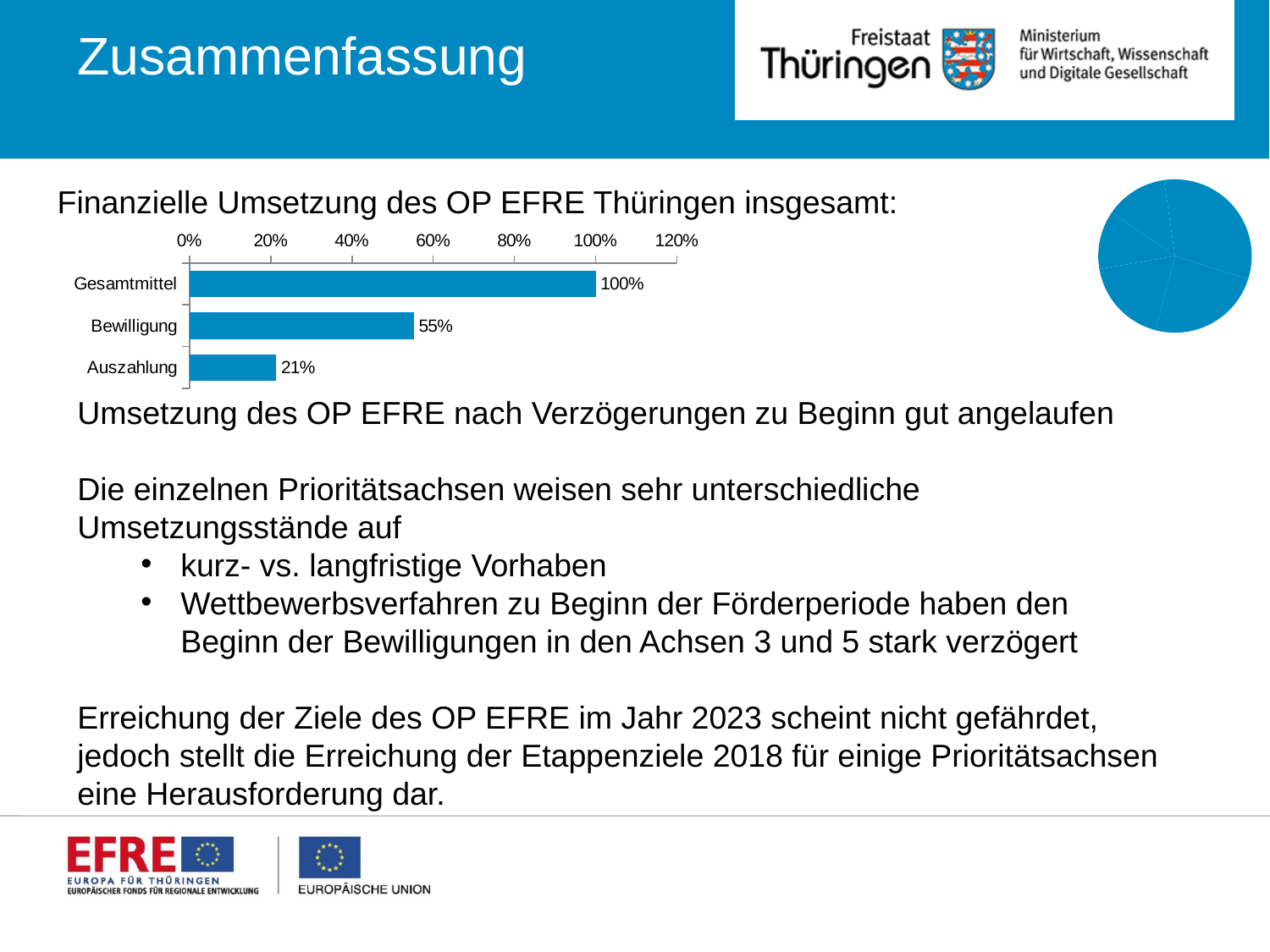
In the bar chart under "Finanzielle Umsetzung des OP EFRE Thüringen insgesamt", which category has the highest value? Gesamtmittel In the bar chart under "Finanzielle Umsetzung des OP EFRE Thüringen insgesamt", how many categories are shown? 3 In the bar chart under "Finanzielle Umsetzung des OP EFRE Thüringen insgesamt", which category has the lowest value? Auszahlung In the bar chart under "Finanzielle Umsetzung des OP EFRE Thüringen insgesamt", what is the value for Gesamtmittel? 100% In the bar chart under "Finanzielle Umsetzung des OP EFRE Thüringen insgesamt", is the value for Bewilligung greater or less than 40%? greater In the bar chart under "Finanzielle Umsetzung des OP EFRE Thüringen insgesamt", what is the value for Bewilligung? 55% In the bar chart under "Finanzielle Umsetzung des OP EFRE Thüringen insgesamt", what is the difference between Bewilligung and Auszahlung? 34% What kind of chart is shown under "Finanzielle Umsetzung des OP EFRE Thüringen insgesamt"? Bar chart In the bar chart under "Finanzielle Umsetzung des OP EFRE Thüringen insgesamt", what is the value for Auszahlung? 21% In the bar chart under "Finanzielle Umsetzung des OP EFRE Thüringen insgesamt", what is the highest tick label on the percentage axis? 120% In the bar chart under "Finanzielle Umsetzung des OP EFRE Thüringen insgesamt", which is larger, Bewilligung or Auszahlung? Bewilligung In the bar chart under "Finanzielle Umsetzung des OP EFRE Thüringen insgesamt", what is the difference between Gesamtmittel and Bewilligung? 45%